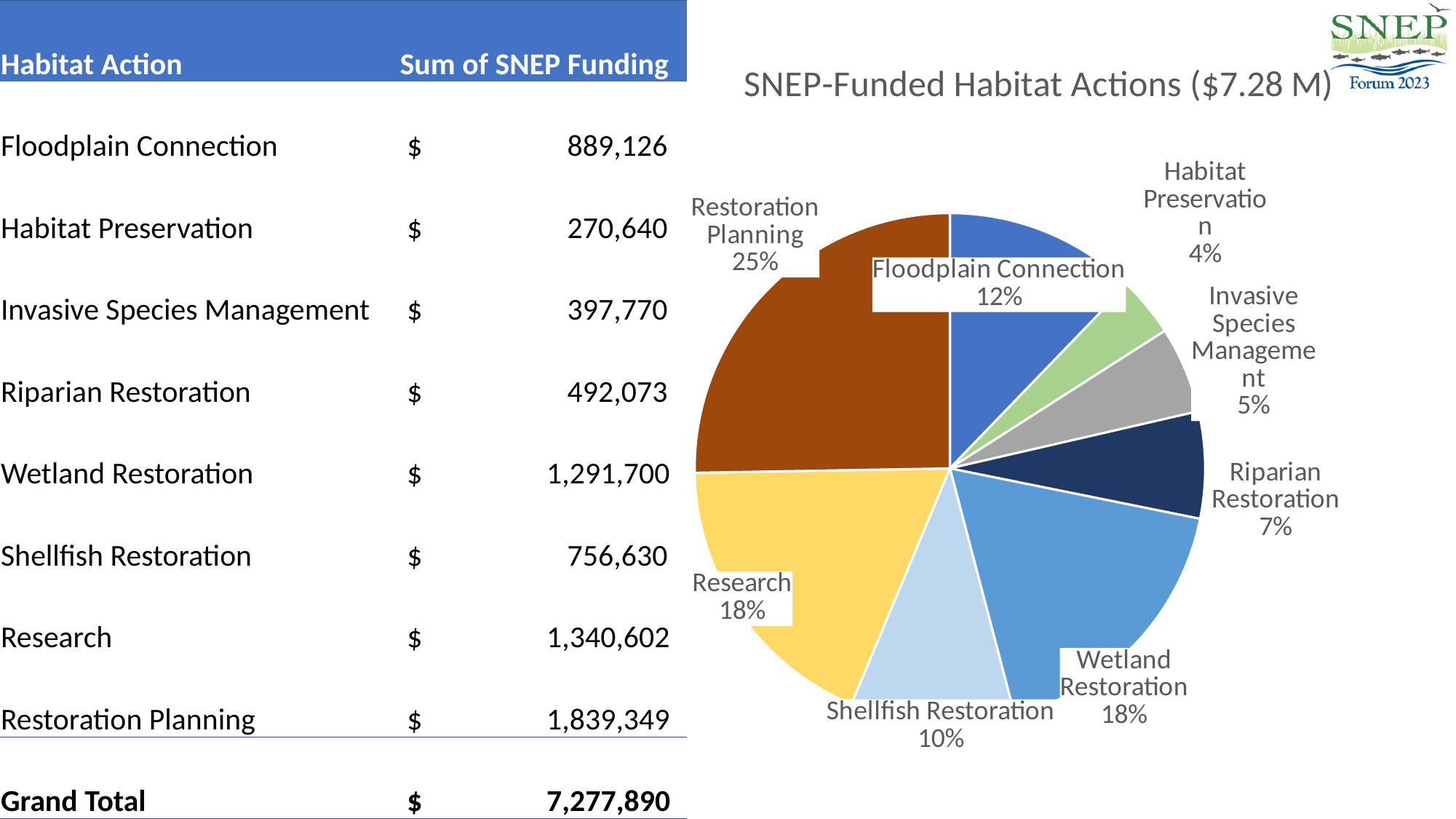
Which slice is larger, Floodplain Connection or Shellfish Restoration? Floodplain Connection Which habitat action has the largest slice of the pie? Restoration Planning What share of the pie does Restoration Planning represent? 25% Which habitat action has the smallest slice of the pie? Habitat Preservation What kind of chart is shown on the slide? pie chart What share of the pie does Riparian Restoration represent? 7% What share of the pie does Invasive Species Management represent? 5% By how many percentage points does the Restoration Planning share exceed the Floodplain Connection share? 13 percentage points What is the title of the pie chart? SNEP-Funded Habitat Actions ($7.28 M) How many slices does the pie chart have? 8